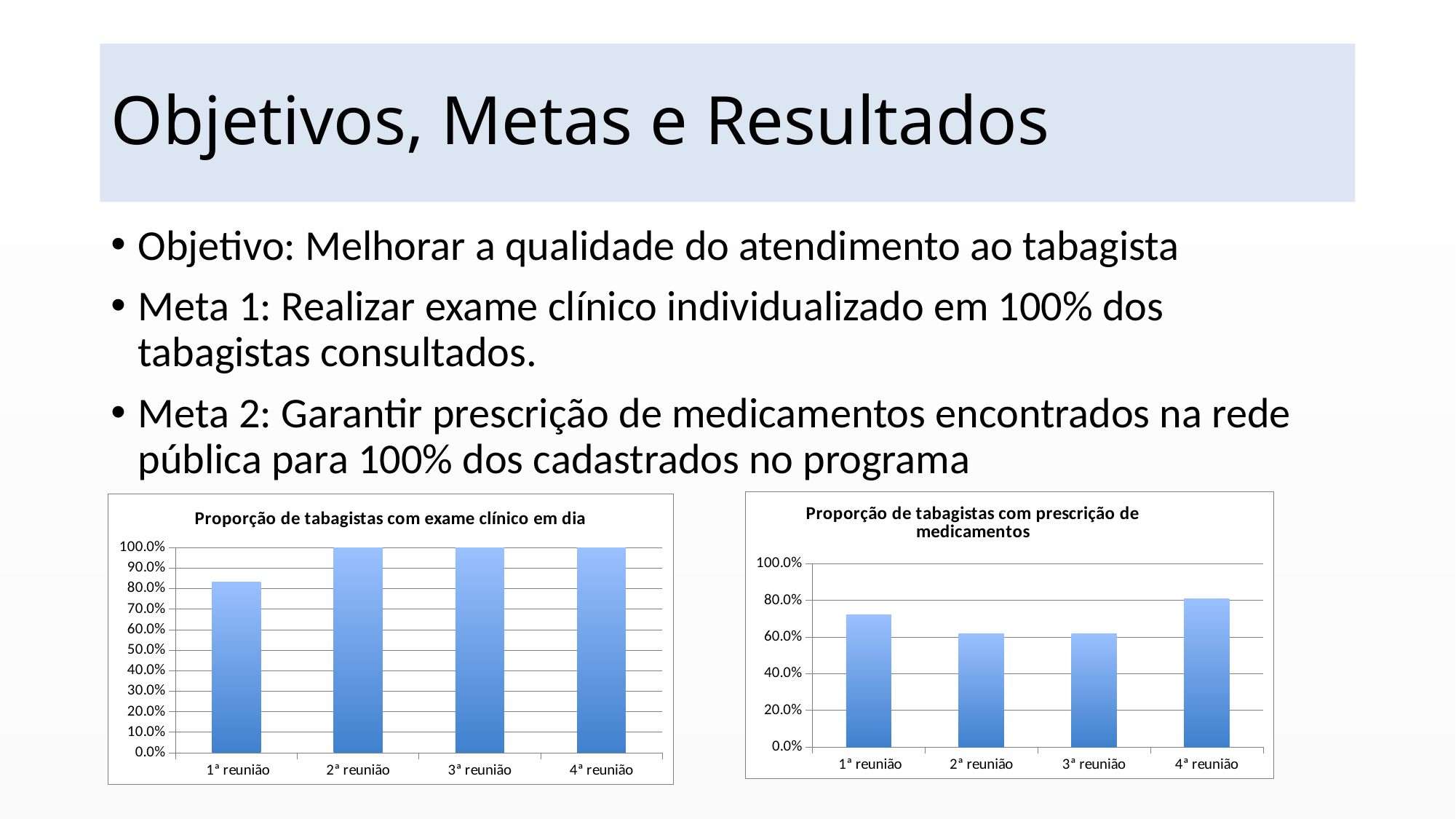
In the chart titled 'Proporção de tabagistas com exame clínico em dia', which category has the lowest value? 1ª reunião In the chart titled 'Proporção de tabagistas com prescrição de medicamentos', which is larger, the value for 1ª reunião or 2ª reunião? 1ª reunião What is the title of the chart on the left side of the slide? Proporção de tabagistas com exame clínico em dia In the chart titled 'Proporção de tabagistas com prescrição de medicamentos', is the value for 1ª reunião greater or less than 60.0%? greater In the chart titled 'Proporção de tabagistas com prescrição de medicamentos', which category has the highest value? 4ª reunião In the chart titled 'Proporção de tabagistas com exame clínico em dia', is the value for 1ª reunião greater or less than 90.0%? less What kind of chart is the chart titled 'Proporção de tabagistas com prescrição de medicamentos'? bar chart In the chart titled 'Proporção de tabagistas com exame clínico em dia', how many categories are shown on the x axis? 4 In the chart titled 'Proporção de tabagistas com exame clínico em dia', what is the value for 2ª reunião? 100.0% In the chart titled 'Proporção de tabagistas com exame clínico em dia', which is larger, the value for 1ª reunião or 3ª reunião? 3ª reunião In the chart titled 'Proporção de tabagistas com prescrição de medicamentos', is the value for 2ª reunião greater or less than 80.0%? less